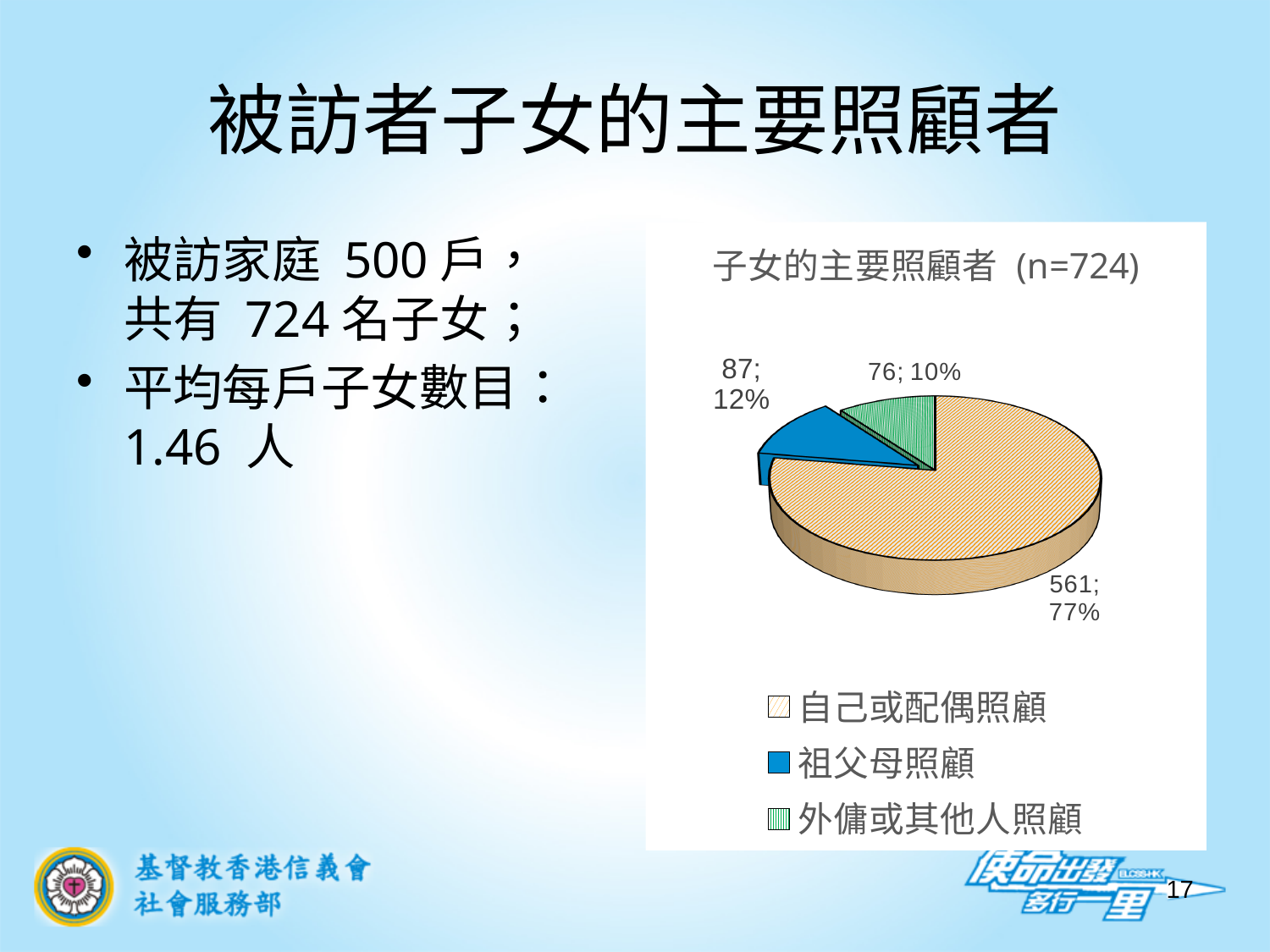
What kind of chart is shown on the slide? pie chart How many children are cared for by 自己或配偶照顧? 561 How many slices does the pie chart have? 3 What is the title of the chart? 子女的主要照顧者 (n=724) What is the difference between the counts for 祖父母照顧 and 外傭或其他人照顧? 11 How many entries does the legend list? 3 How many children are cared for by 祖父母照顧? 87 How many children are cared for by 外傭或其他人照顧? 76 Which category has the smallest slice? 外傭或其他人照顧 Which category has the largest slice? 自己或配偶照顧 What share of the pie does 外傭或其他人照顧 represent? 10% What share of the pie does 自己或配偶照顧 represent? 77%